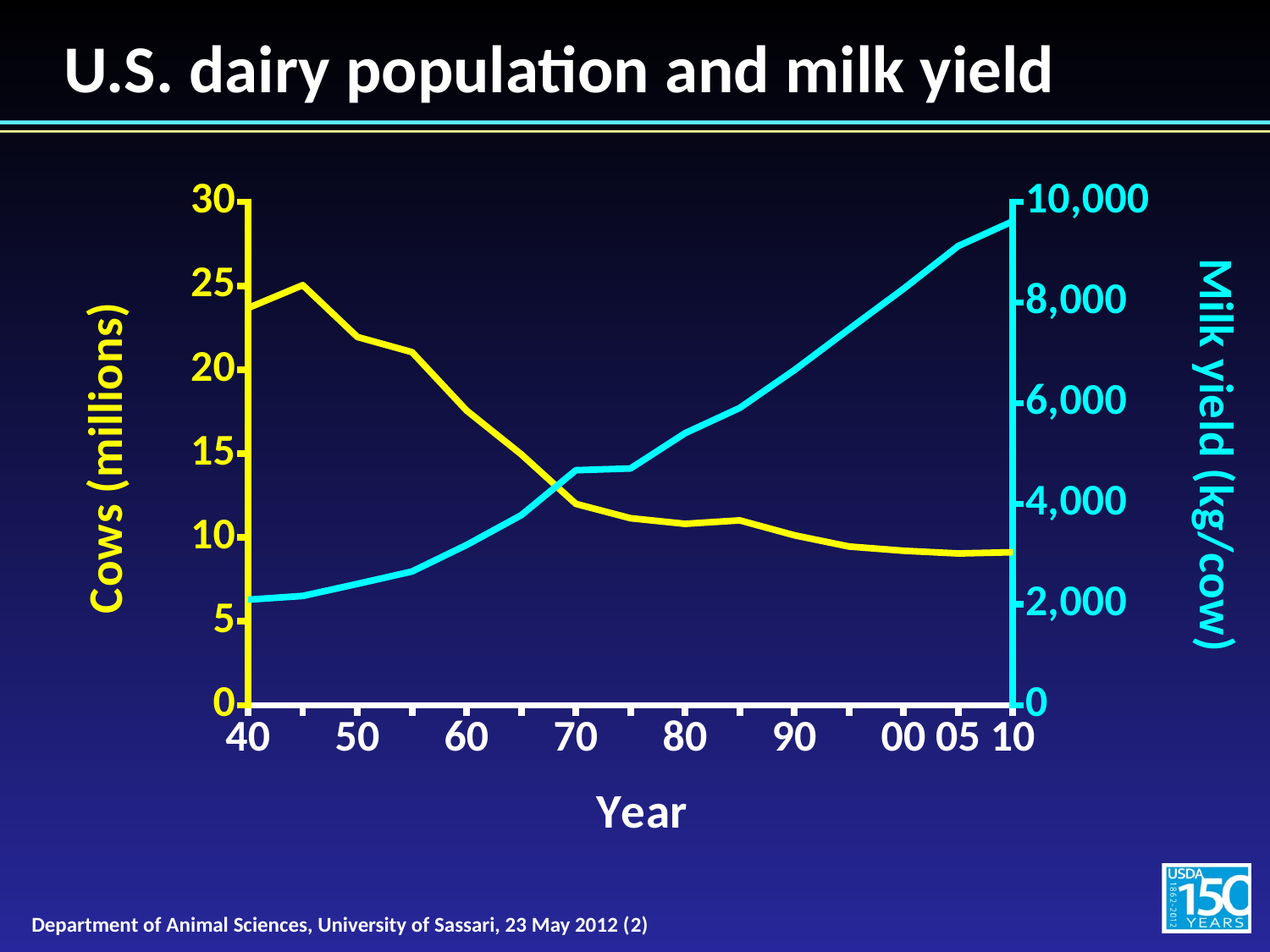
Is the milk yield (kg/cow) in 1940 greater or less than 4,000? less Which is larger: the number of cows (millions) in 1940 or in 2010? 1940 What is the title of the right-hand y axis? Milk yield (kg/cow) How does milk yield (kg/cow) change from 1940 to 2010 along the x axis? rises In which year is milk yield (kg/cow) lowest? 40 How does the number of cows (millions) change from 1950 to 2010 along the x axis? falls Is the milk yield (kg/cow) in 2010 greater or less than 8,000? greater Is the number of cows (millions) in 1970 greater or less than 15? less What kind of chart is shown on the slide? line chart In which year is milk yield (kg/cow) highest? 10